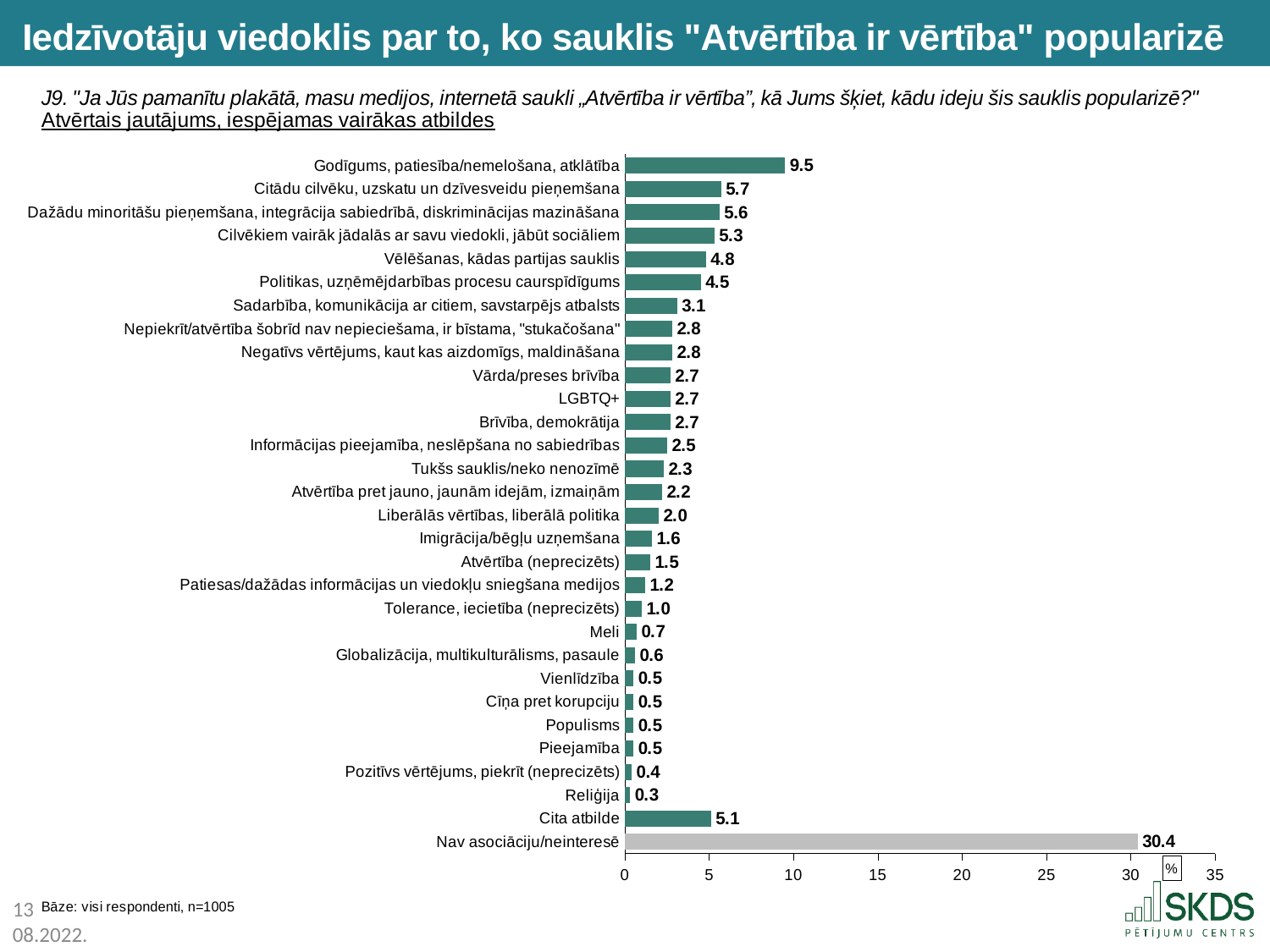
Which category has the lowest value? Reliģija What is the value for "LGBTQ+"? 2.7 Which is larger: the value for "Vēlēšanas, kādas partijas sauklis" or the value for "Politikas, uzņēmējdarbības procesu caurspīdīgums"? Vēlēšanas, kādas partijas sauklis What is the base (n) stated below the chart? n=1005 What is the value for "Nav asociāciju/neinteresē"? 30.4 How many categories are shown in the chart? 30 What is the difference between the values for "Godīgums, patiesība/nemelošana, atklātība" and "Citādu cilvēku, uzskatu un dzīvesveidu pieņemšana"? 3.8 Which category has the highest value? Nav asociāciju/neinteresē Is the value for "Nav asociāciju/neinteresē" greater or less than 25? greater What is the value for "Cita atbilde"? 5.1 What is the value for "Godīgums, patiesība/nemelošana, atklātība"? 9.5 What kind of chart is shown on the slide? bar chart